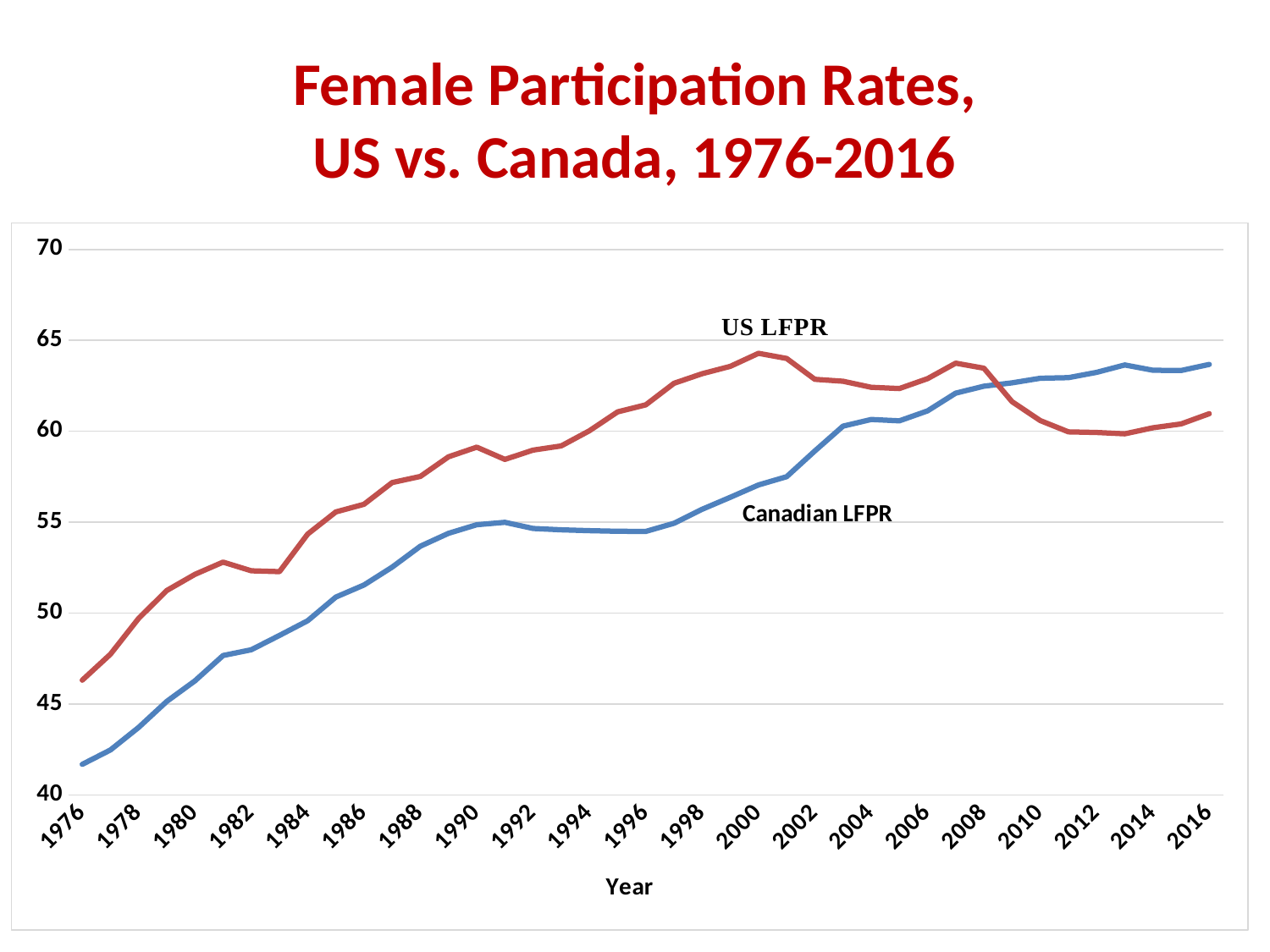
Is the Canadian LFPR value for 1976 greater or less than 45? less What kind of chart is shown on the slide? Line chart How many data series are plotted on the chart? 2 What is the title of the chart on the slide? Female Participation Rates, US vs. Canada, 1976-2016 What is the label of the x axis? Year In 2016, which series has the higher value, US LFPR or Canadian LFPR? Canadian LFPR Is the Canadian LFPR value for 2016 greater or less than 65? less In 1976, which series has the higher value, US LFPR or Canadian LFPR? US LFPR Is the US LFPR value for 2000 greater or less than 65? less Does the Canadian LFPR generally rise or fall from 1976 to 2016? Rise